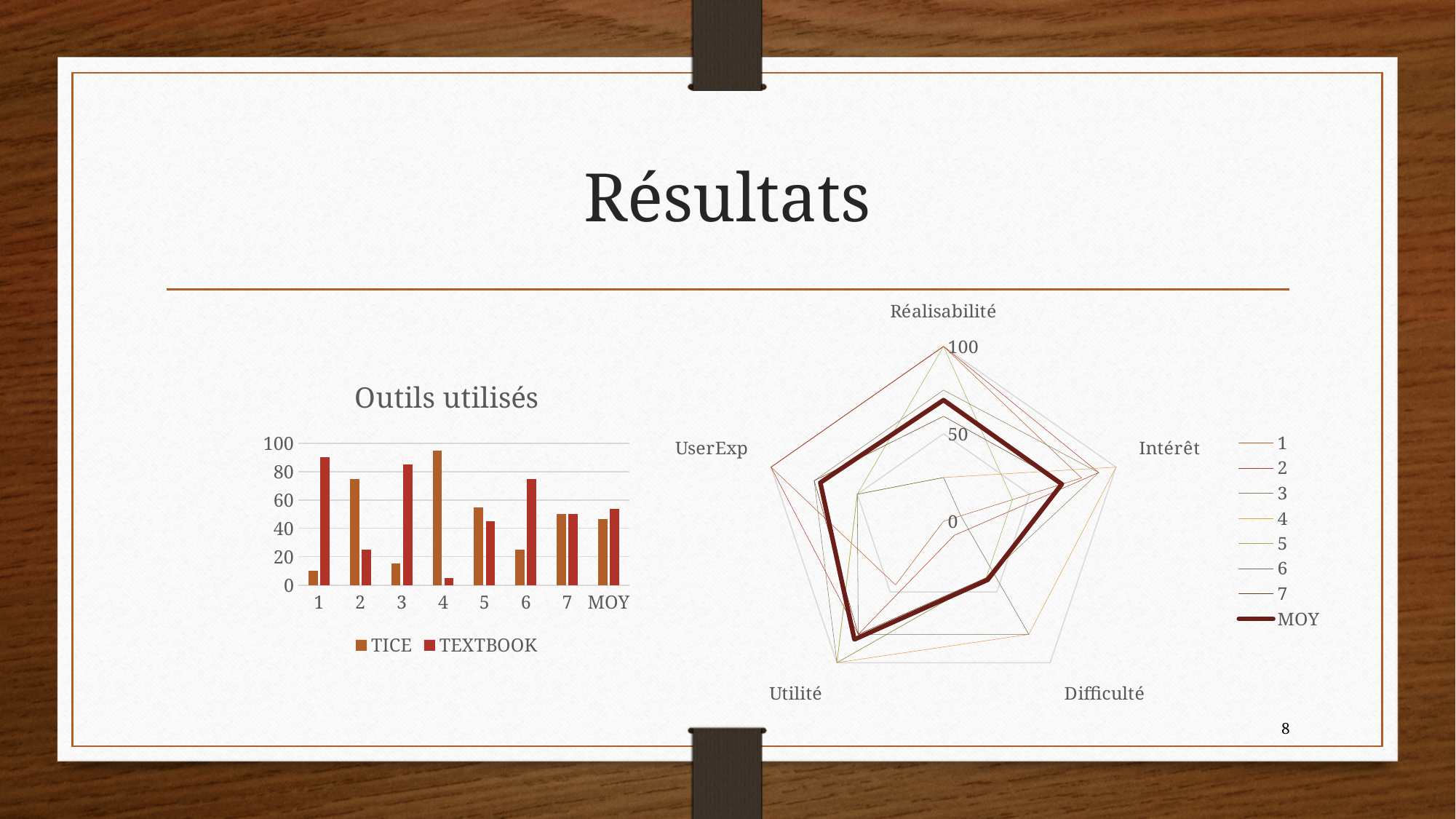
How many categories are shown on the x axis of the "Outils utilisés" chart? 8 In the "Outils utilisés" chart, for category 2, which is larger: TICE or TEXTBOOK? TICE In the "Outils utilisés" chart, which category has the lowest TEXTBOOK value? 4 In the "Outils utilisés" chart, which category has the highest TICE value? 4 In the radar chart on the right, is the MOY value for Réalisabilité greater or less than 50? greater What kind of chart is the "Outils utilisés" chart? bar chart In the "Outils utilisés" chart, is the TEXTBOOK value for category 1 greater or less than 80? greater How many series does the legend of the radar chart on the right list? 8 What kind of chart is the chart on the right of the slide? radar chart What are the two legend entries of the "Outils utilisés" chart? TICE and TEXTBOOK In the "Outils utilisés" chart, is the TICE value for category 1 greater or less than 20? less How many series does the legend of the "Outils utilisés" chart list? 2